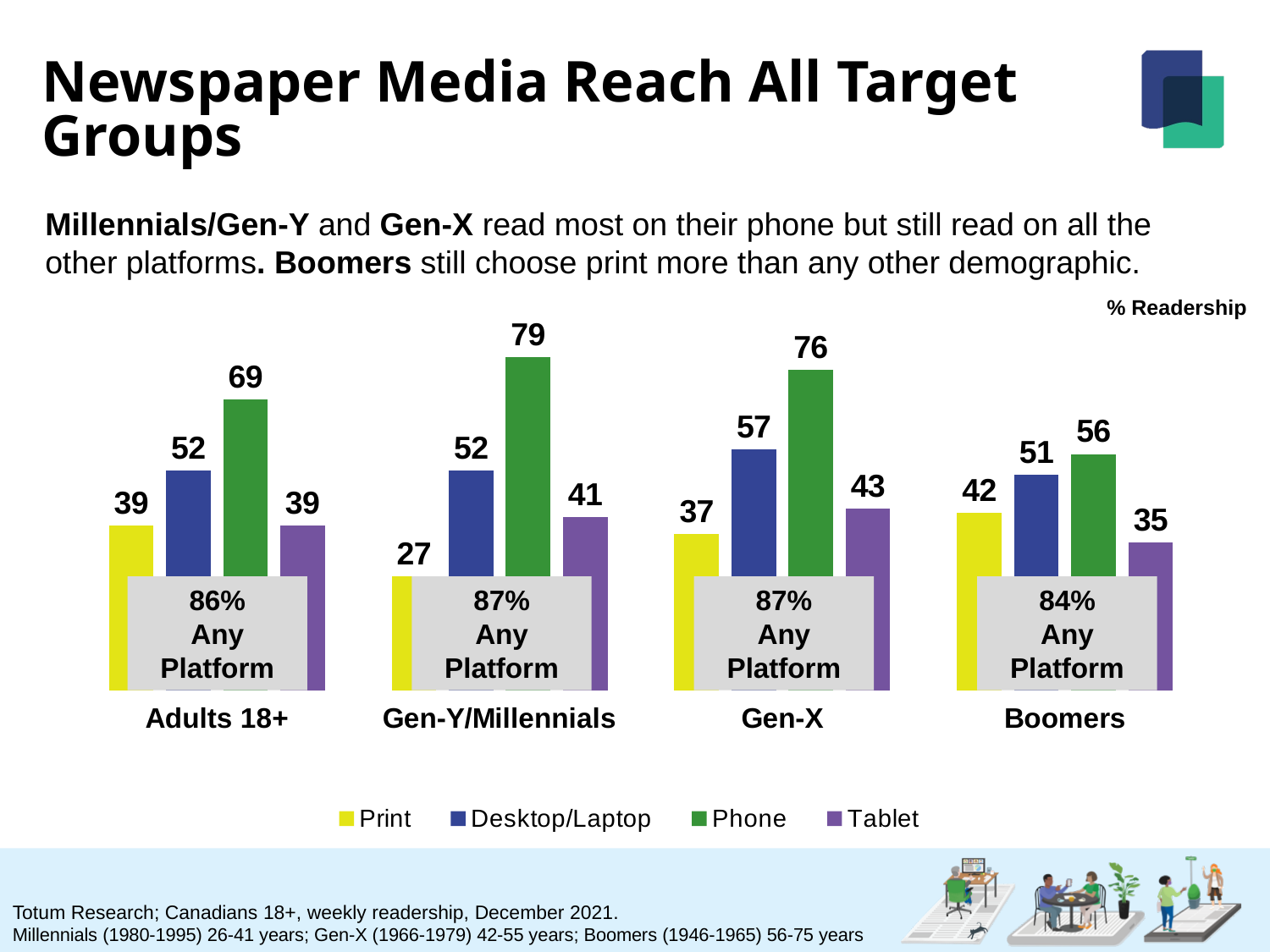
Which is larger for Boomers: Desktop/Laptop readership or Tablet readership? Desktop/Laptop What is the difference between Phone and Print readership for Gen-X? 39 Which demographic group has the lowest Print readership? Gen-Y/Millennials Which colour represents the Phone series in the legend? Green What is the Tablet readership value for Gen-X? 43 How many demographic groups are shown on the x axis? 4 Which demographic group has the highest Phone readership? Gen-Y/Millennials What is the Phone readership value for Gen-Y/Millennials? 79 How many series does the legend list? 4 What is the 'Any Platform' readership percentage for Boomers? 84% What kind of chart is shown on the slide? Bar chart What is the Print readership value for Boomers? 42